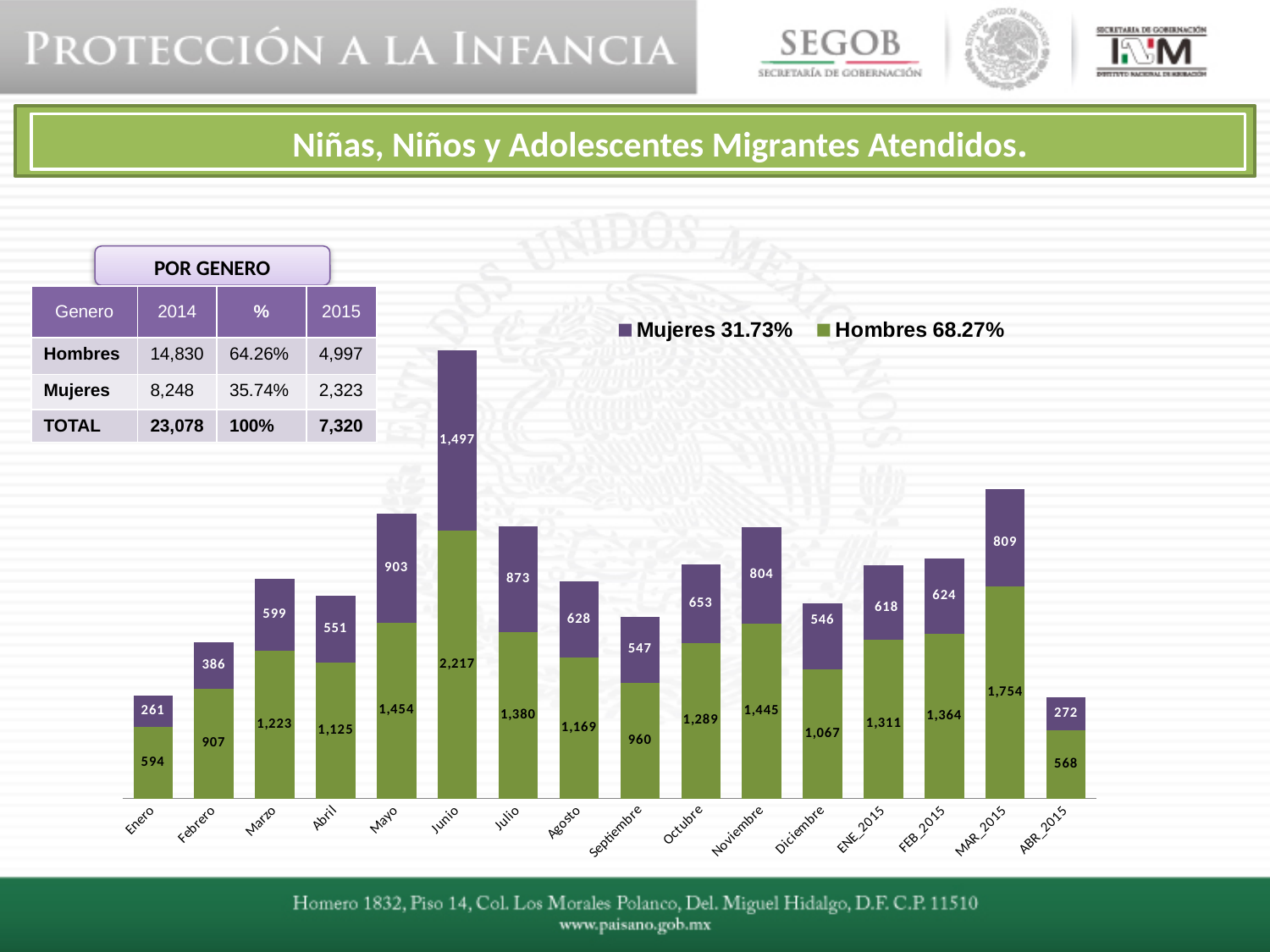
What is the Hombres value for Junio? 2,217 Which month has the highest Mujeres value? Junio What percentage is shown next to Hombres in the legend? 68.27% What kind of chart is shown? Stacked bar chart What is the Mujeres value for Marzo? 599 How many series does the legend list? 2 Which is larger, the Mujeres value for Noviembre or the Mujeres value for Octubre? Noviembre How many months are shown on the x axis? 16 What is the total of the stacked bar for Enero? 855 What is the Hombres value for MAR_2015? 1,754 What is the difference between the Hombres values for Mayo and Abril? 329 Which month has the lowest Hombres value? ABR_2015